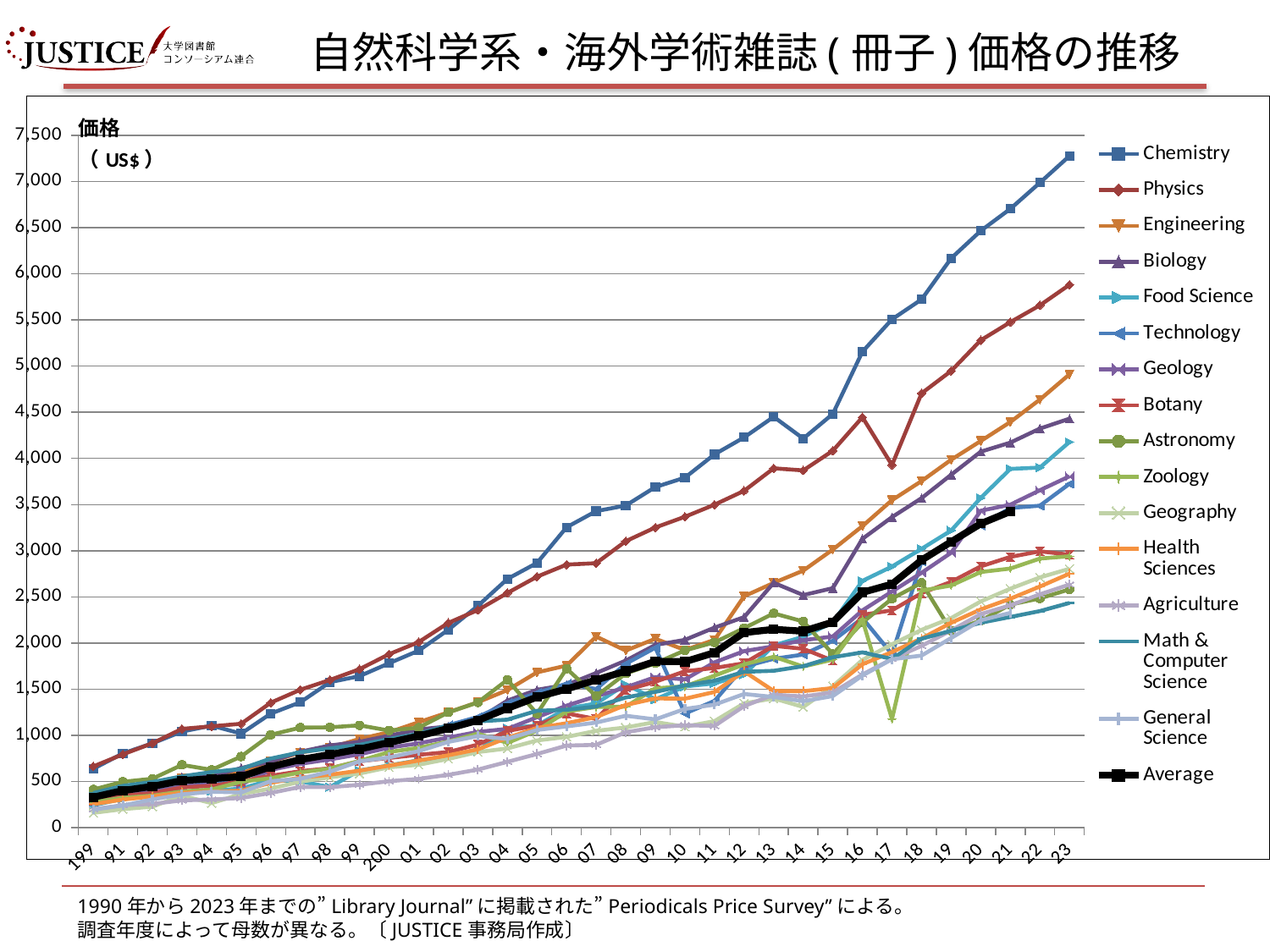
Is the value for Average in 2021 greater or less than 3,000? greater What kind of chart is shown on the slide? line chart Is the value for Chemistry in 1990 greater or less than 1,000? less Does the Chemistry series generally rise or fall from 1990 to 2023? rise How many years are plotted along the x axis? 34 Which is larger in 2023, Chemistry or Physics? Chemistry Which is larger in 2023, Engineering or Biology? Engineering Which series has the highest value in 2023? Chemistry Is the value for Chemistry in 2023 greater or less than 7,000? greater What unit is shown for the y axis (価格)? US$ How many series does the legend list? 16